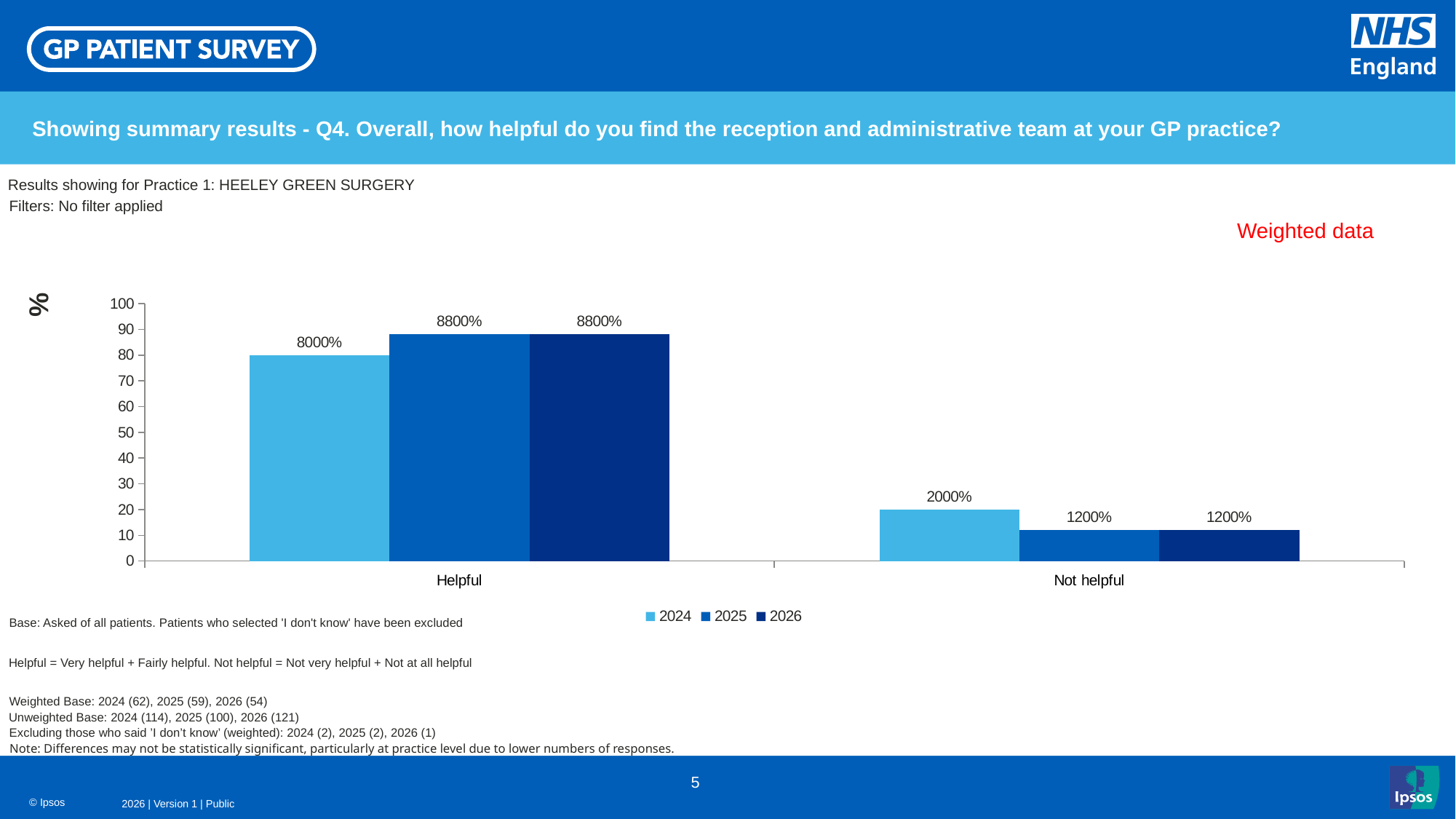
Is the 2024 Helpful bar larger or smaller than the 2024 Not helpful bar? larger What kind of chart is shown on the slide? bar chart What is the data label for the 2025 bar in the Helpful category? 8800% What is the data label for the 2026 bar in the Not helpful category? 1200% What is the data label for the 2024 bar in the Helpful category? 8000% How many categories are shown on the x axis? 2 Is the value for the 2025 Not helpful bar greater or less than 20 on the axis? less How many series does the legend list? 3 Which year has the lowest value in the Helpful category? 2024 What is the data label for the 2024 bar in the Not helpful category? 2000% Which year has the highest value in the Not helpful category? 2024 Which practice are the results shown for? Practice 1: HEELEY GREEN SURGERY